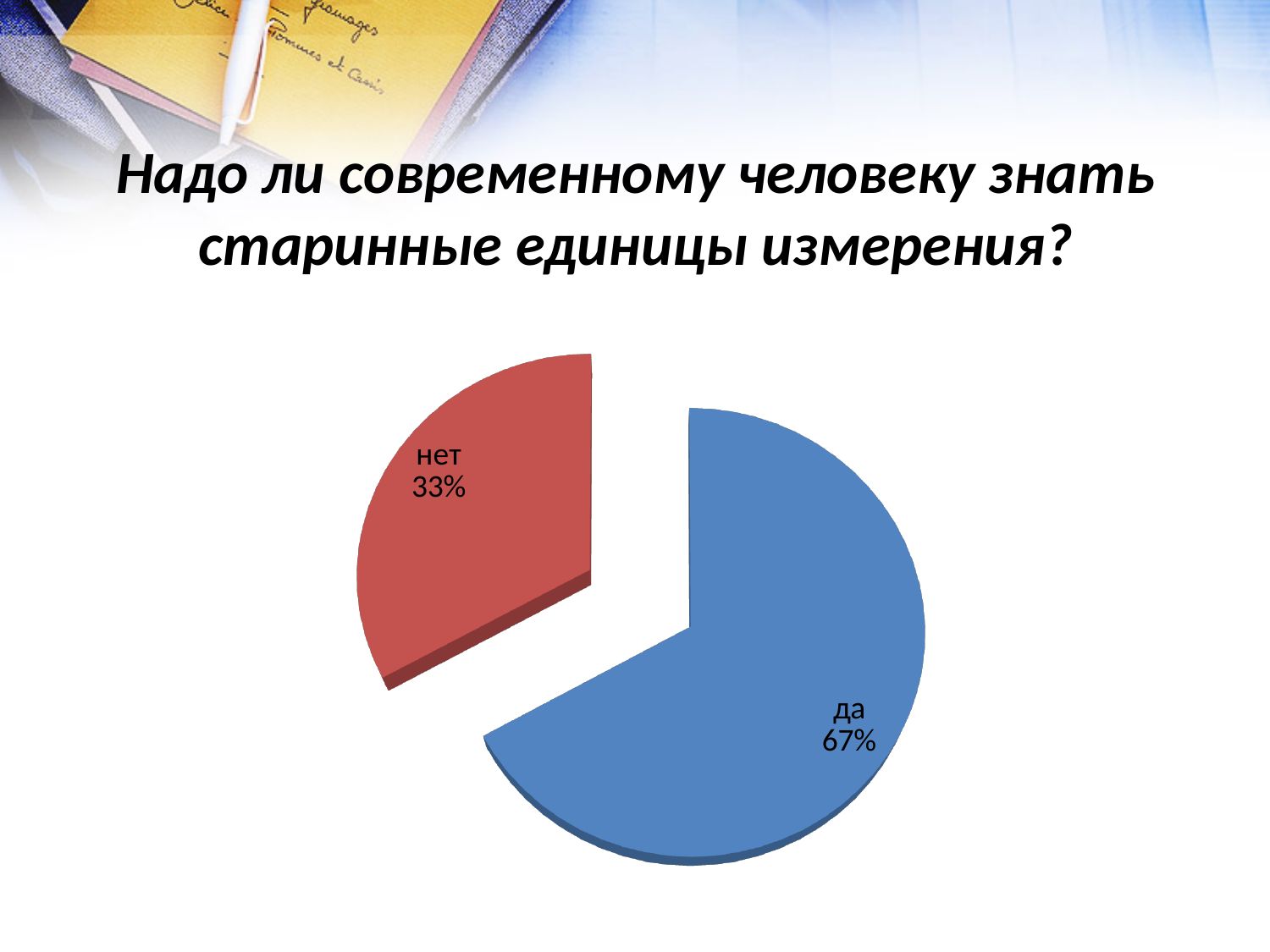
What colour is the "нет" slice? red Which slice is the smallest? нет Which slice is the largest? да What is the difference in percentage points between the "да" and "нет" slices? 34 What kind of chart is shown on the slide? pie chart Which is larger, the "да" slice or the "нет" slice? да Is the value for "да" greater or less than 50%? greater How many slices does the pie chart have? 2 What share of the pie does the "да" slice represent? 67% What colour is the "да" slice? blue What share of the pie does the "нет" slice represent? 33%